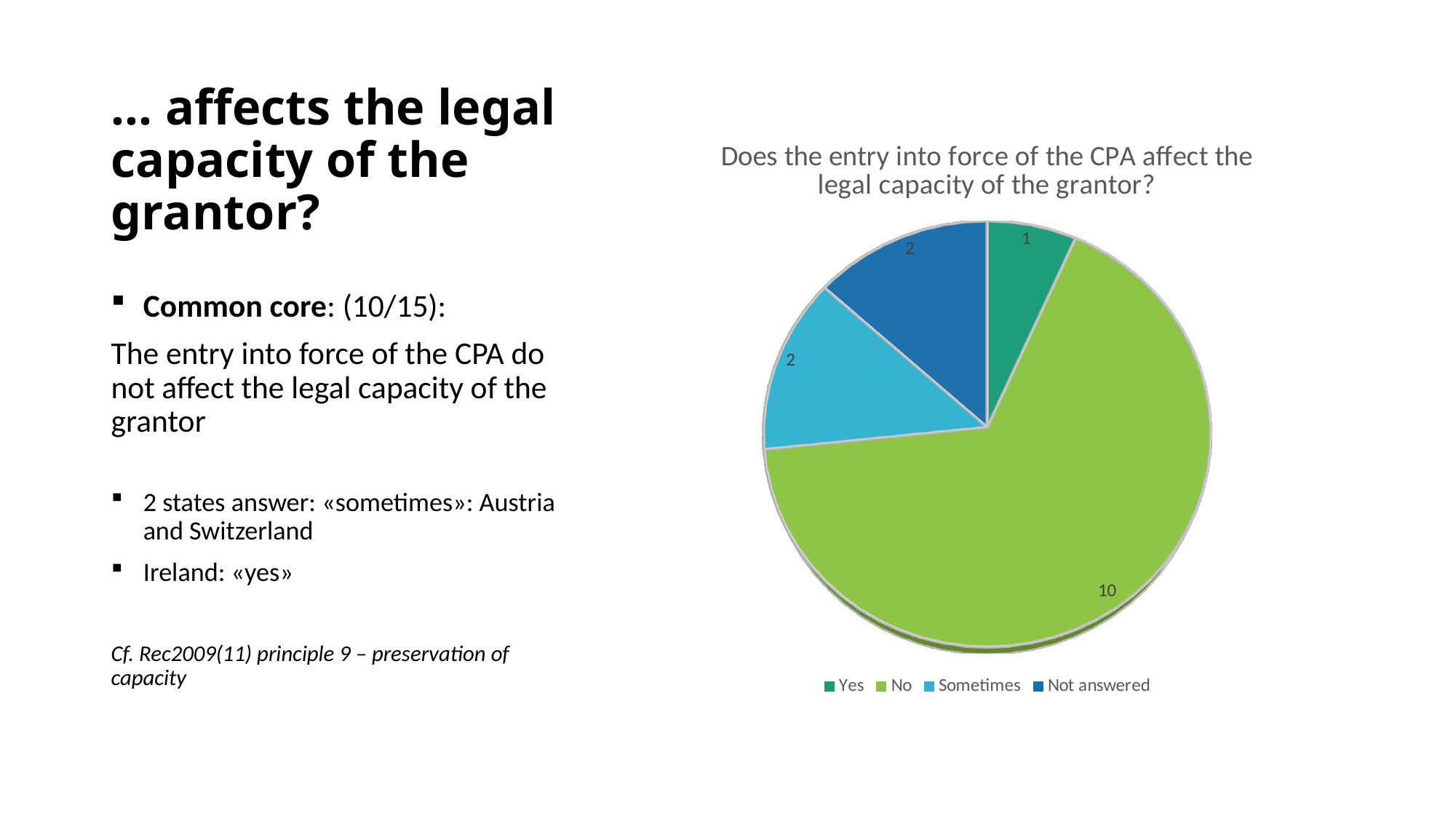
What is the value of the 'Yes' slice? 1 Which is larger, the 'No' slice or the 'Yes' slice? No What type of chart is shown on the slide? Pie chart Which category has the largest slice in the pie chart? No What is the value of the 'No' slice? 10 What is the value of the 'Sometimes' slice? 2 What is the title of the chart? Does the entry into force of the CPA affect the legal capacity of the grantor? How many categories does the legend of the pie chart list? 4 Which category has the smallest slice in the pie chart? Yes What is the total of all slices in the pie chart? 15 What is the difference between the 'No' value and the 'Sometimes' value? 8 What is the value of the 'Not answered' slice? 2